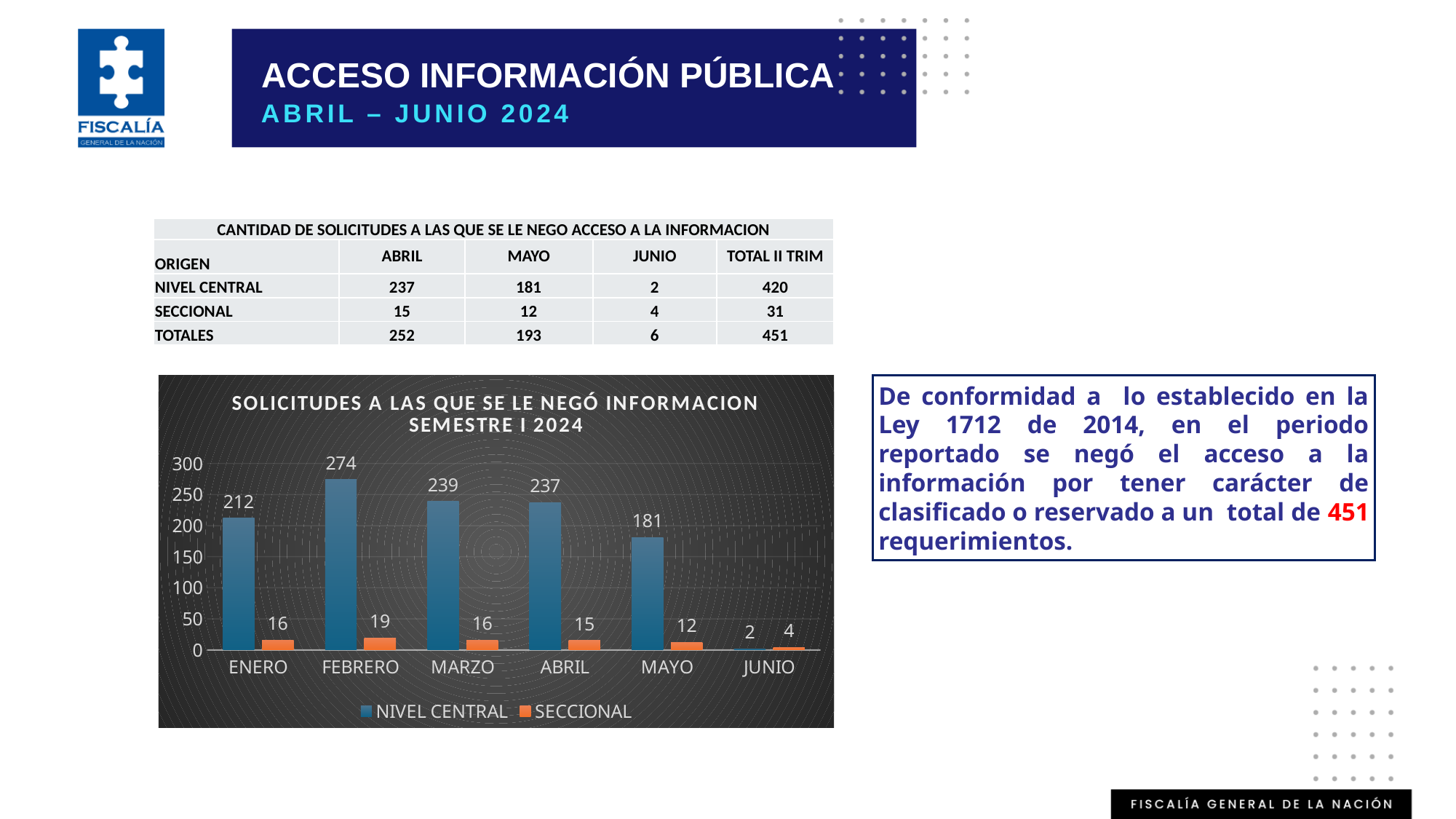
What is the difference between the NIVEL CENTRAL values for MARZO and ABRIL? 2 Which is larger, the SECCIONAL value for FEBRERO or for ENERO? FEBRERO What is the title of the chart? SOLICITUDES A LAS QUE SE LE NEGÓ INFORMACION SEMESTRE I 2024 Which month has the highest NIVEL CENTRAL value? FEBRERO What kind of chart is shown? bar chart How many series does the legend list? 2 How many months are shown on the x axis? 6 Is the NIVEL CENTRAL value for MAYO greater or less than 200? less What is the value for NIVEL CENTRAL in FEBRERO? 274 What is the value for NIVEL CENTRAL in JUNIO? 2 What is the value for SECCIONAL in MAYO? 12 Which month has the lowest SECCIONAL value? JUNIO